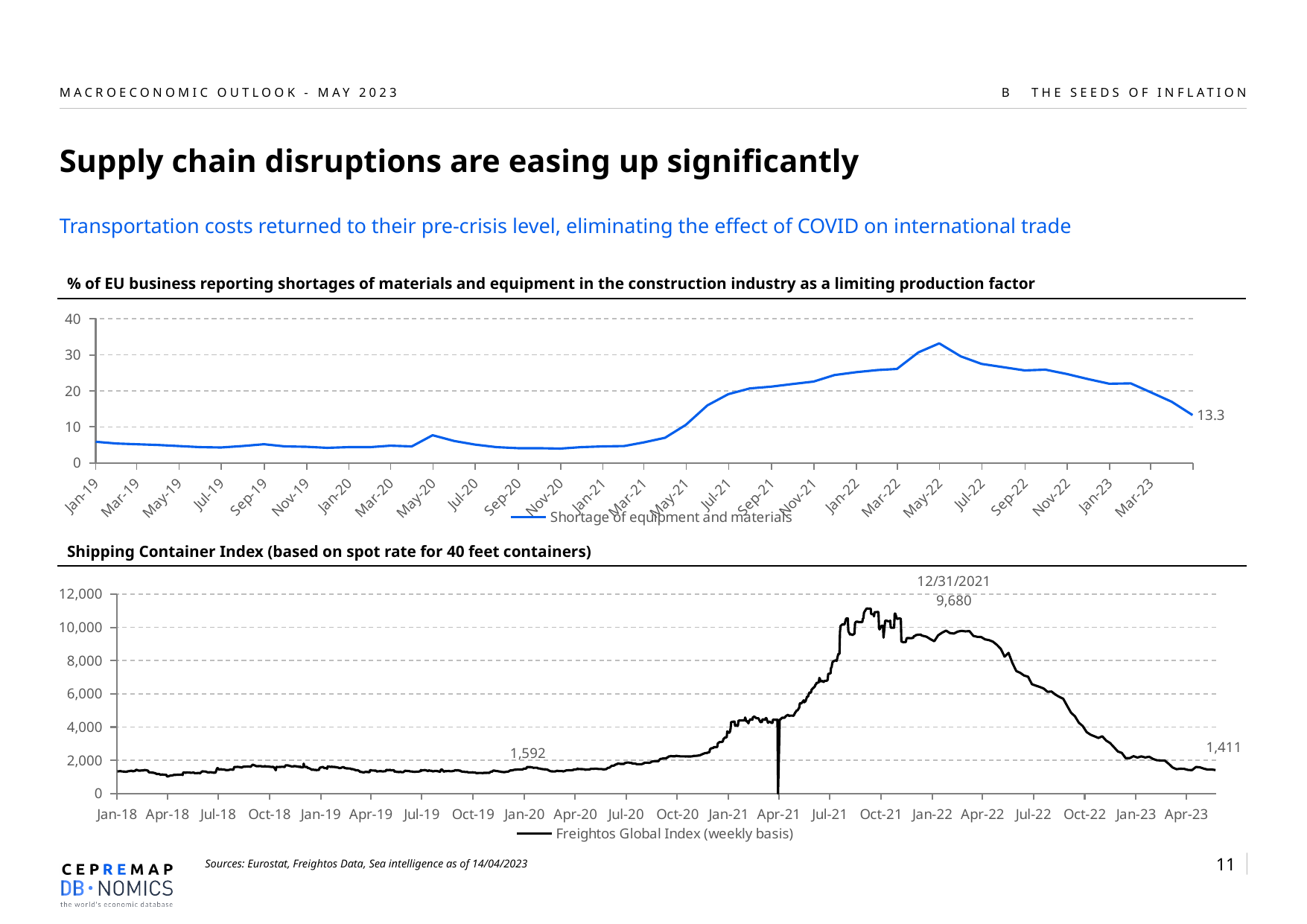
On the bottom chart (Shipping Container Index), what is the difference between the value labeled at 12/31/2021 and the final labeled value? 8,269 On the top chart (% of EU business reporting shortages), is the value at Jan-19 greater or less than 10? less On the top chart (% of EU business reporting shortages), what is the value printed at the end of the line? 13.3 On the bottom chart (Shipping Container Index), what series name does the legend show? Freightos Global Index (weekly basis) On the bottom chart (Shipping Container Index), what value is labeled at 12/31/2021? 9,680 On the bottom chart (Shipping Container Index), does the index rise or fall between Jan-22 and Apr-23? fall On the bottom chart (Shipping Container Index), is the value at Apr-22 greater or less than 8,000? greater On the bottom chart (Shipping Container Index), what is the value printed at the end of the line? 1,411 On the top chart (% of EU business reporting shortages), what series name does the legend show? Shortage of equipment and materials What kind of chart is the top chart, '% of EU business reporting shortages of materials and equipment in the construction industry as a limiting production factor'? line chart How many series does the legend of the top chart (% of EU business reporting shortages) list? 1